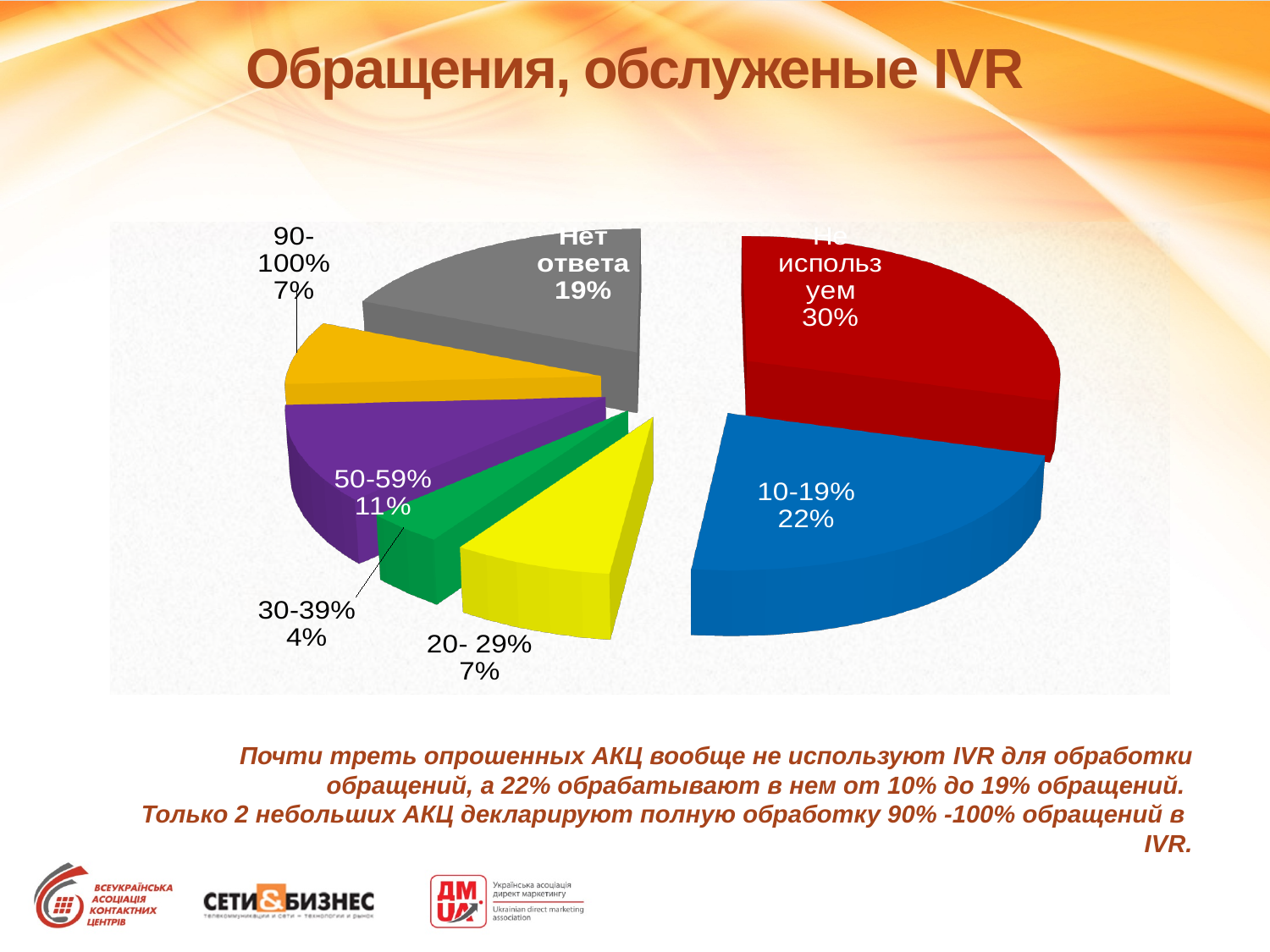
What kind of chart is shown on the slide? Pie chart What share of the pie does the "Нет ответа" slice represent? 19% What share of the pie does the "30-39%" slice represent? 4% Which slice of the pie is the smallest? 30-39% What is the difference in percentage points between the "Не используем" slice and the "10-19%" slice? 8 What share of the pie is labelled "Не используем"? 30% What is the title of the chart on the slide? Обращения, обслуженые IVR Which slice is larger, "50-59%" or "20- 29%"? 50-59% How many slices does the pie chart have? 7 Which slice of the pie is the largest? Не используем